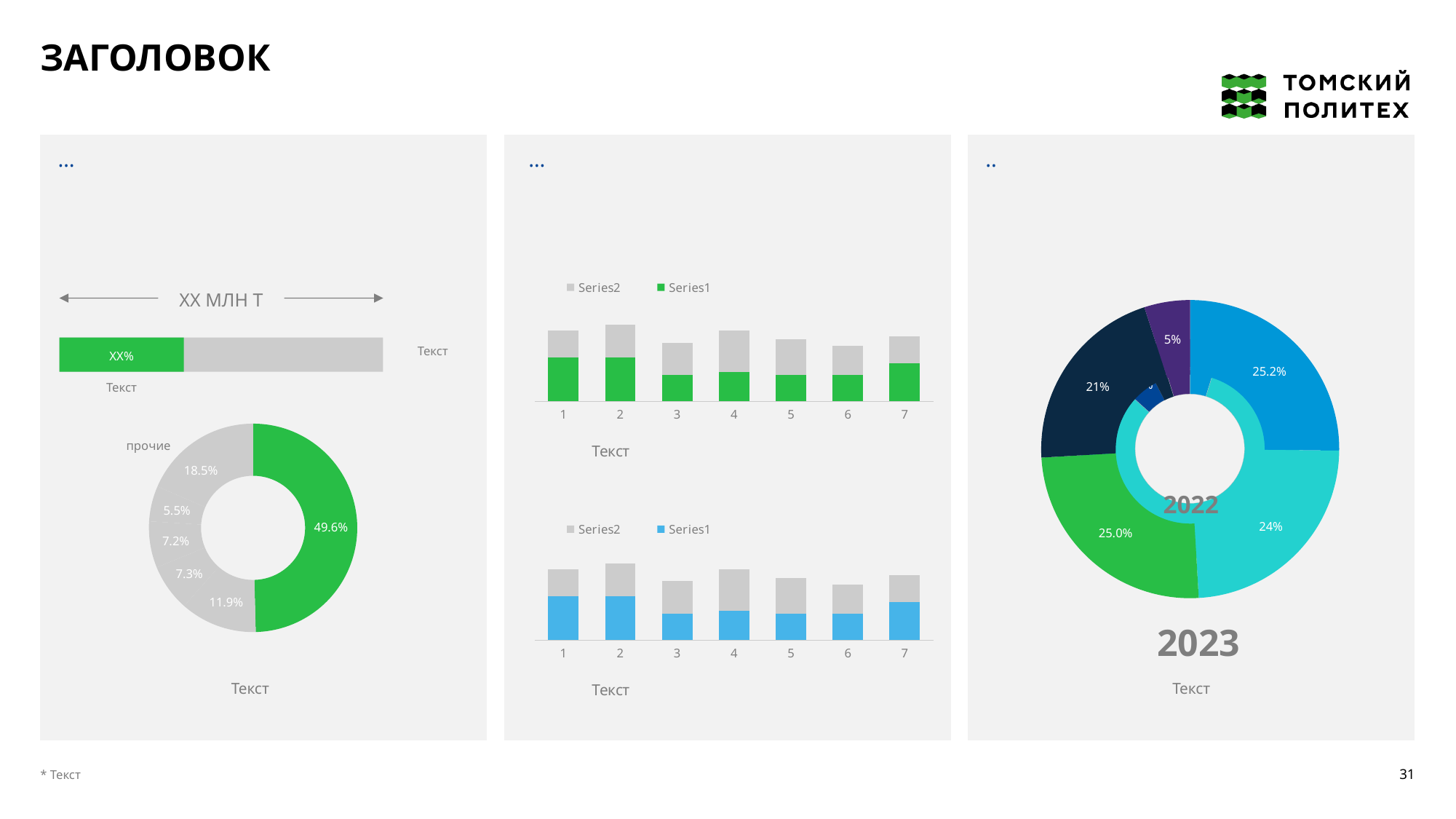
How many categories are shown on the x axis of the upper bar chart in the middle panel? 7 In the donut chart on the left panel, which is larger: the 7.3% slice or the 11.9% slice? 11.9% In the donut chart on the left panel, how many slices are there? 6 In the nested donut chart on the right panel, what is the difference between the 25.2% slice and the 24% slice on the outer ring? 1.2 percentage points In the nested donut chart on the right panel, what is the smallest labelled value on the outer (2023) ring? 5% In the donut chart on the left panel, what is the value of the largest slice? 49.6% What kind of chart is the upper chart in the middle panel? Stacked bar chart In the donut chart on the left panel, what is the value of the slice labelled 'прочие'? 18.5% How many series does the legend of the lower bar chart in the middle panel list? 2 In the lower bar chart in the middle panel, what colour represents Series1? Blue In the donut chart on the left panel, what is the difference between the 49.6% slice and the 18.5% slice? 31.1 percentage points In the upper bar chart in the middle panel, which category has the tallest stacked bar? 2